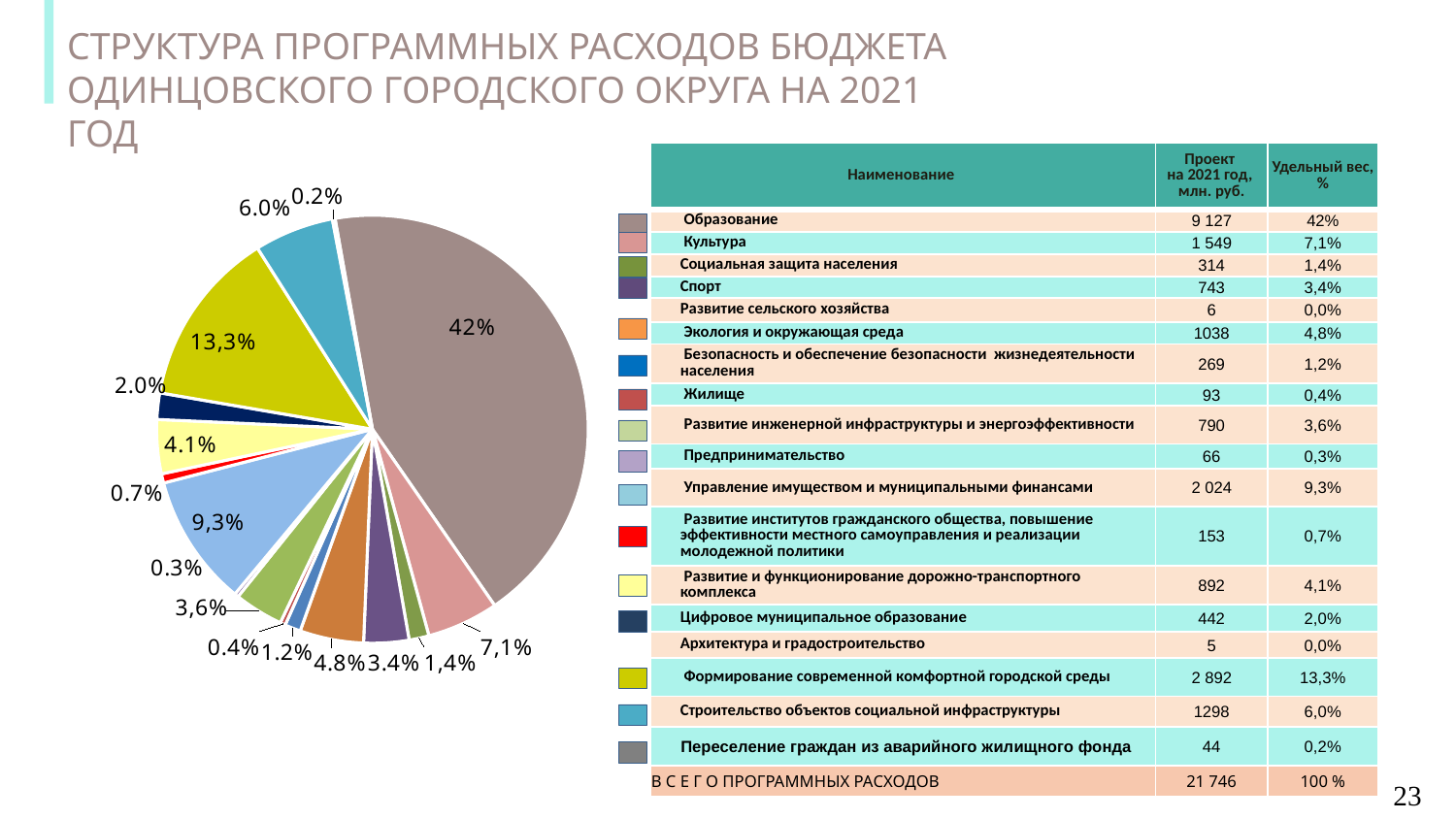
What share of the pie chart does Формирование современной комфортной городской среды account for? 13,3% What share of the pie chart does Управление имуществом и муниципальными финансами account for? 9,3% What is the combined share of the Образование and Культура slices? 49,1% What share of the pie chart does Образование account for? 42% What share of the pie chart does Культура account for? 7,1% What is the title of the slide containing the pie chart? СТРУКТУРА ПРОГРАММНЫХ РАСХОДОВ БЮДЖЕТА ОДИНЦОВСКОГО ГОРОДСКОГО ОКРУГА НА 2021 ГОД How many percentage data labels are shown on the pie chart? 16 What is the difference in percentage points between the Образование slice and the Культура slice? 34,9% What share of the pie chart does Строительство объектов социальной инфраструктуры account for? 6,0% Which category has the largest slice of the pie chart? Образование Which slice is larger: Формирование современной комфортной городской среды or Управление имуществом и муниципальными финансами? Формирование современной комфортной городской среды What kind of chart is shown on the slide? pie chart